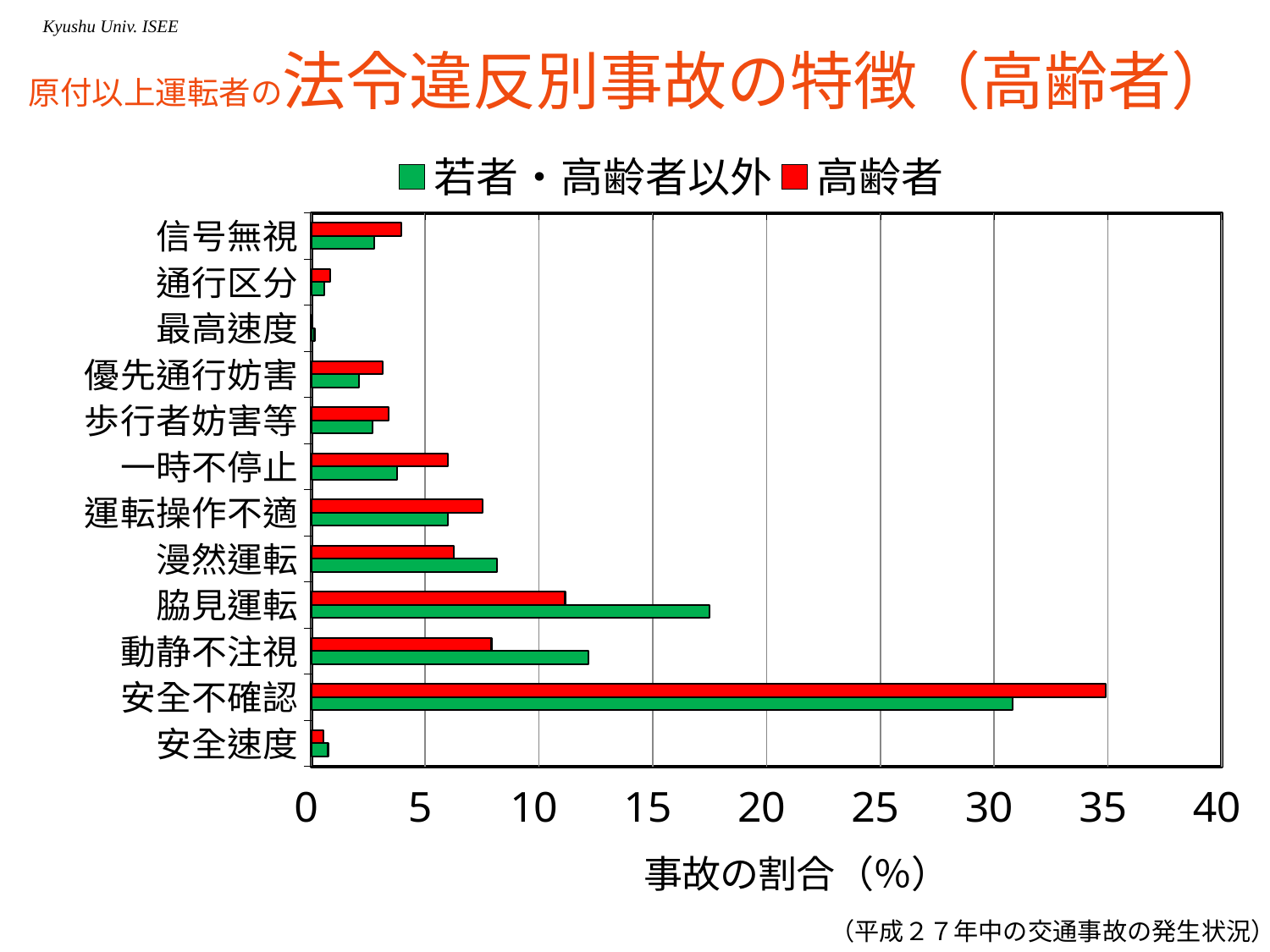
Which category has the highest value for the 高齢者 series? 安全不確認 Is the 高齢者 value for 安全不確認 greater or less than 30? greater Which category has the lowest value for the 若者・高齢者以外 series? 最高速度 What colour represents the 高齢者 series in the legend? red Is the 高齢者 value for 一時不停止 greater or less than 5? greater For 脇見運転, which series has the larger value, 若者・高齢者以外 or 高齢者? 若者・高齢者以外 For 安全不確認, which series has the larger value, 若者・高齢者以外 or 高齢者? 高齢者 Is the 高齢者 value for 動静不注視 greater or less than 10? less How many violation categories are plotted on the y axis? 12 How many series does the legend list? 2 What kind of chart is shown on the slide? bar chart